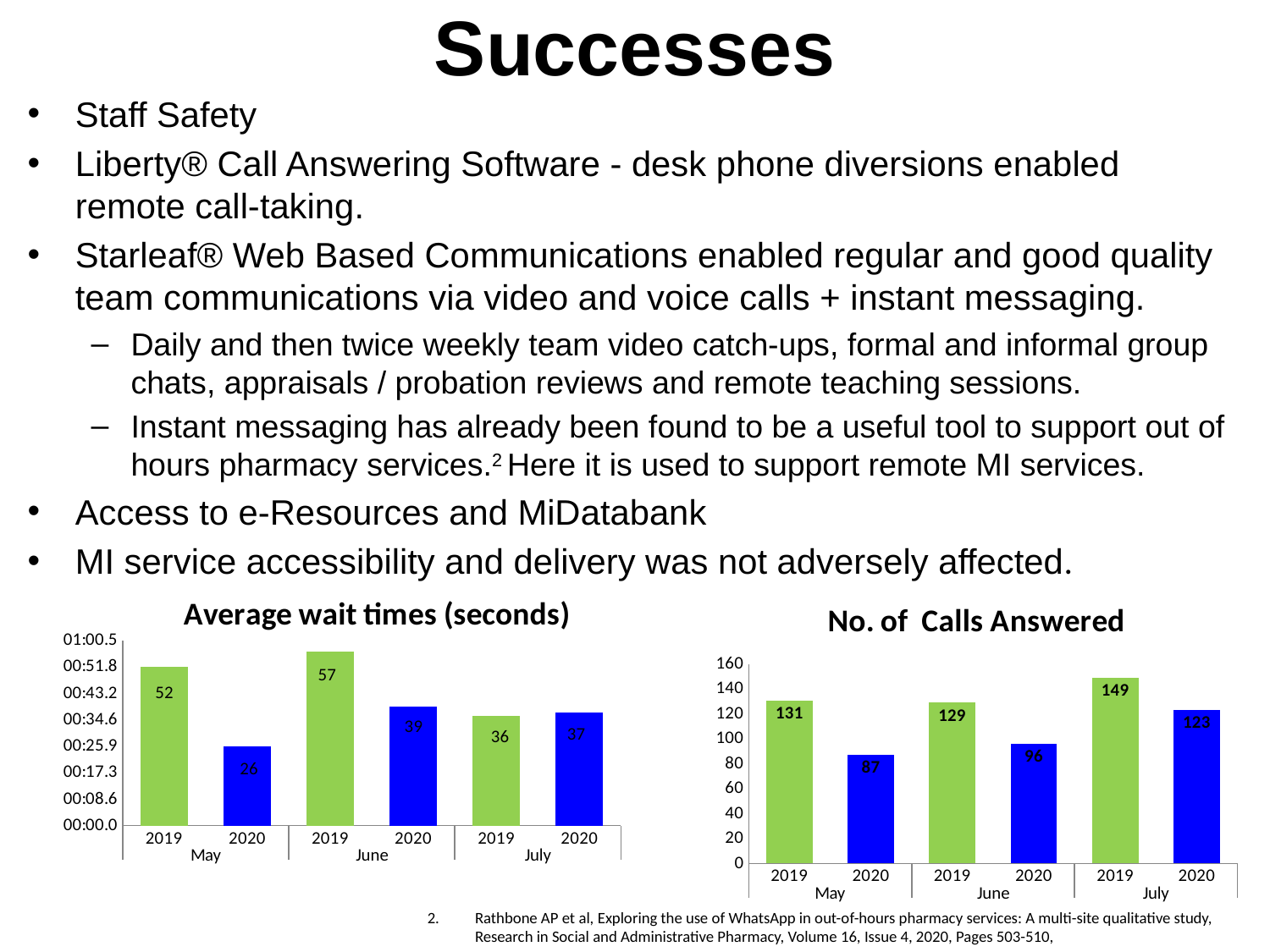
In the 'No. of Calls Answered' chart, what is the difference between the 2019 and 2020 values for July? 26 In the 'Average wait times (seconds)' chart, which bar has the highest value? 2019 in June In the 'No. of Calls Answered' chart, which is larger: the 2019 value for May or the 2019 value for June? 2019 in May In the 'No. of Calls Answered' chart, what is the value for 2020 in July? 123 What kind of chart is the 'No. of Calls Answered' chart? Bar chart In the 'No. of Calls Answered' chart, which bar has the lowest value? 2020 in May In the 'No. of Calls Answered' chart, which bar has the highest value? 2019 in July In the 'Average wait times (seconds)' chart, what is the value for 2019 in May? 52 In the 'Average wait times (seconds)' chart, what is the value for 2020 in June? 39 In the 'Average wait times (seconds)' chart, which bar has the lowest value? 2020 in May In the 'Average wait times (seconds)' chart, what is the difference between the 2019 and 2020 values for May? 26 In the 'No. of Calls Answered' chart, what is the value for 2019 in June? 129